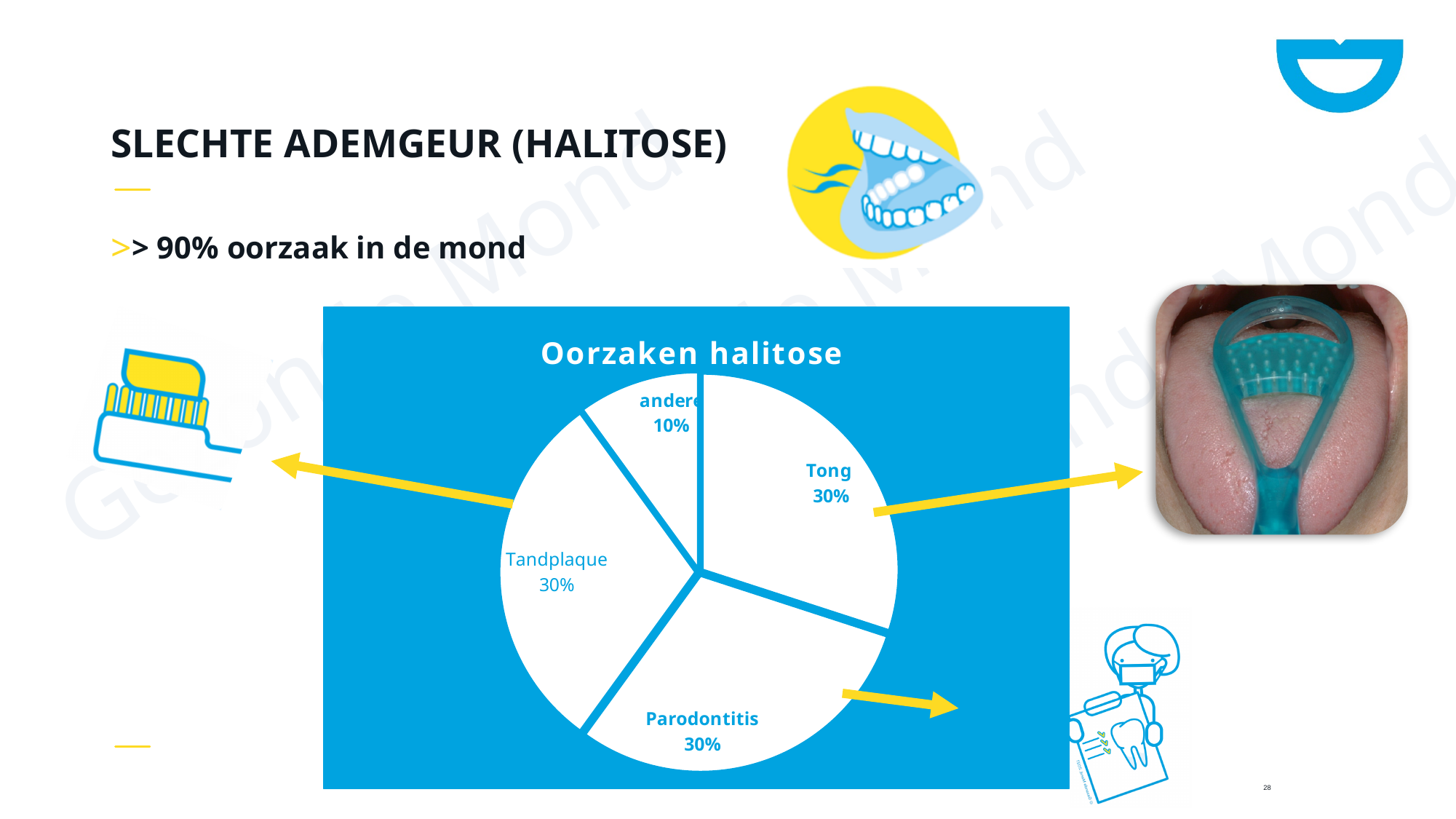
What percentage does the Tandplaque slice represent? 30% What percentage does the andere slice represent? 10% What is the title of the chart? Oorzaken halitose Is the value for andere greater or less than 20%? less What percentage does the Parodontitis slice represent? 30% How many slices does the pie chart have? 4 What kind of chart is shown on the slide? pie chart Which is larger, the Tong slice or the andere slice? Tong What is the difference between the Parodontitis share and the andere share? 20% Which category has the smallest slice of the pie? andere What percentage does the Tong slice represent? 30% What share of the pie do Tong, Tandplaque and Parodontitis make up together? 90%